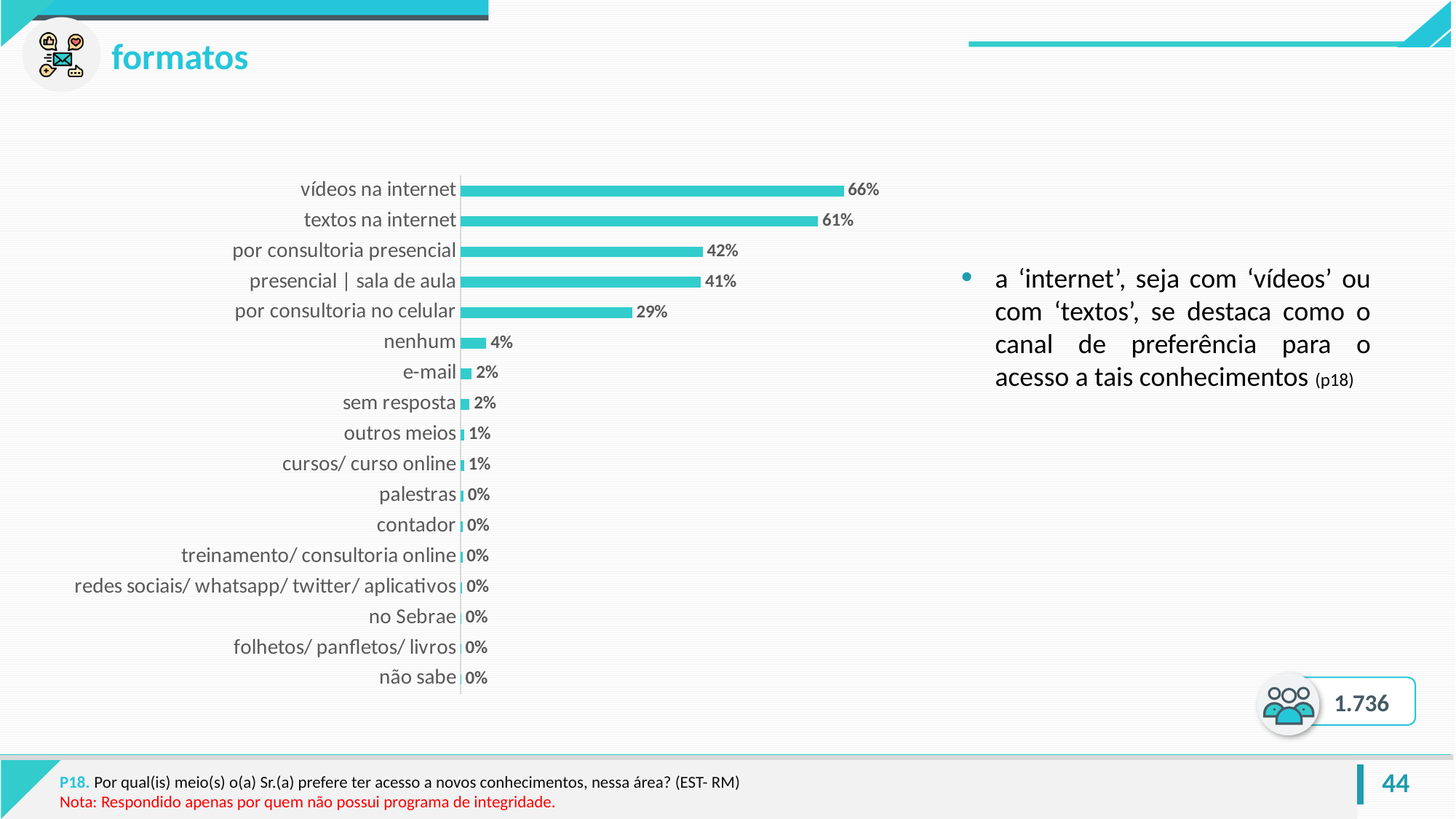
What is the value for 'nenhum'? 4% What is the difference between 'por consultoria presencial' and 'por consultoria no celular'? 13% How many categories are shown in the chart? 17 Which is larger, 'por consultoria presencial' or 'presencial | sala de aula'? por consultoria presencial What is the difference between 'vídeos na internet' and 'textos na internet'? 5% What kind of chart is shown on the slide? bar chart What is the value for 'presencial | sala de aula'? 41% Which is larger, 'nenhum' or 'e-mail'? nenhum Which category has the highest value? vídeos na internet What is the value for 'vídeos na internet'? 66% What is the value for 'por consultoria no celular'? 29% What is the value for 'cursos/ curso online'? 1%